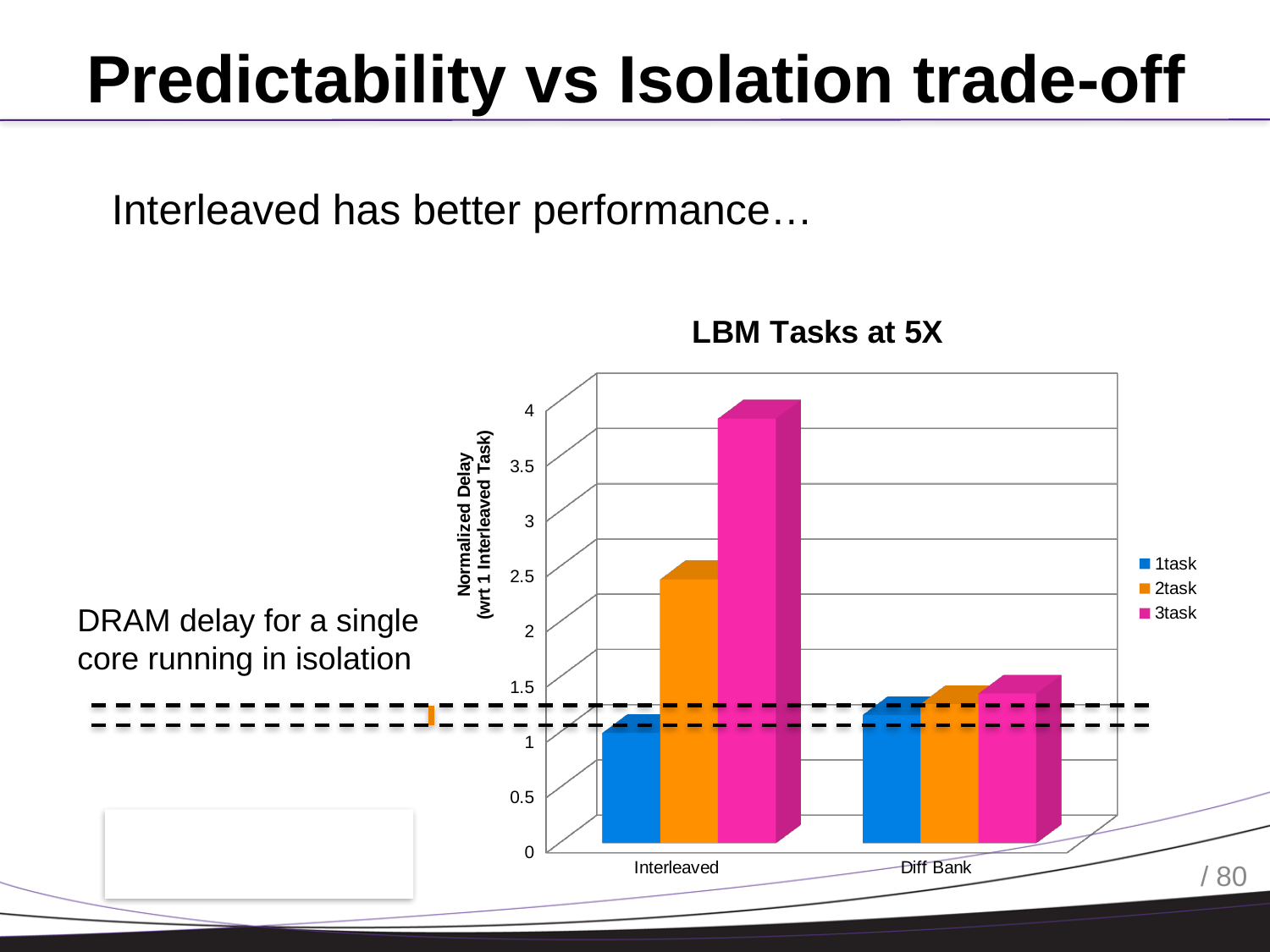
Is the value for 3task under Interleaved greater or less than 3? greater Which is larger: the 2task value for Interleaved or the 2task value for Diff Bank? Interleaved Which category and series has the highest bar in the chart? 3task for Interleaved How many series does the legend list? 3 Is the value for 3task under Diff Bank greater or less than 2? less Is the value for 1task under Diff Bank greater or less than 2? less How many categories are shown on the x axis? 2 Which is larger: the 3task value for Interleaved or the 3task value for Diff Bank? Interleaved What is the label of the y axis? Normalized Delay (wrt 1 Interleaved Task) What is the title of the chart? LBM Tasks at 5X What kind of chart is shown on the slide? bar chart